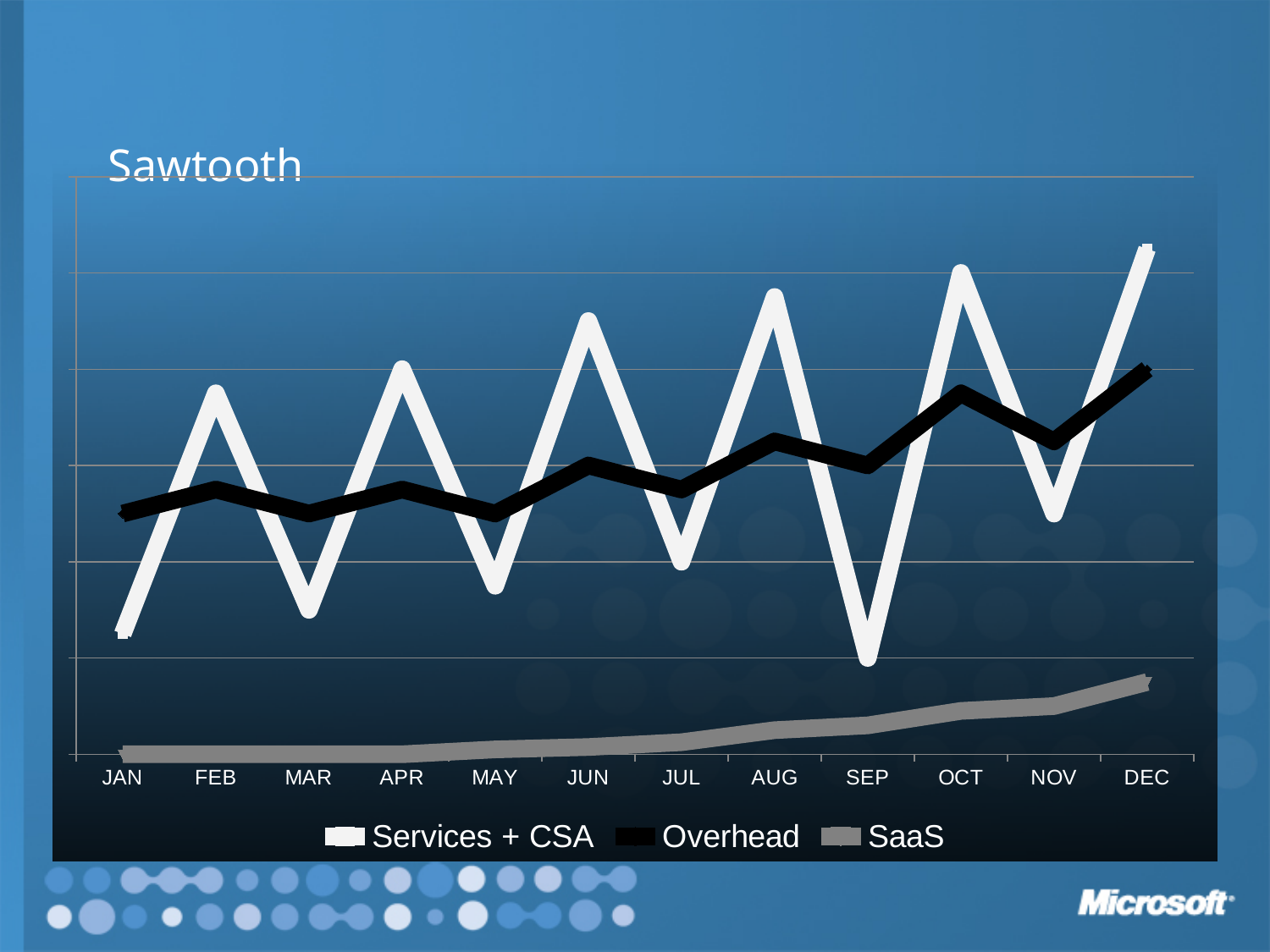
What is the title of the chart? Sawtooth In which month does the SaaS series reach its highest point? DEC In which month does the Services + CSA series reach its lowest point? SEP What kind of chart is shown on the slide? line chart Which series stays lowest across all months? SaaS How many months are plotted along the x axis? 12 In JAN, which is higher: Services + CSA or Overhead? Overhead In which month does the Overhead series reach its highest point? DEC In OCT, which is higher: Services + CSA or Overhead? Services + CSA How many series does the legend list? 3 Does the SaaS series rise or fall from JAN to DEC? rise In which month does the Services + CSA series reach its highest point? DEC